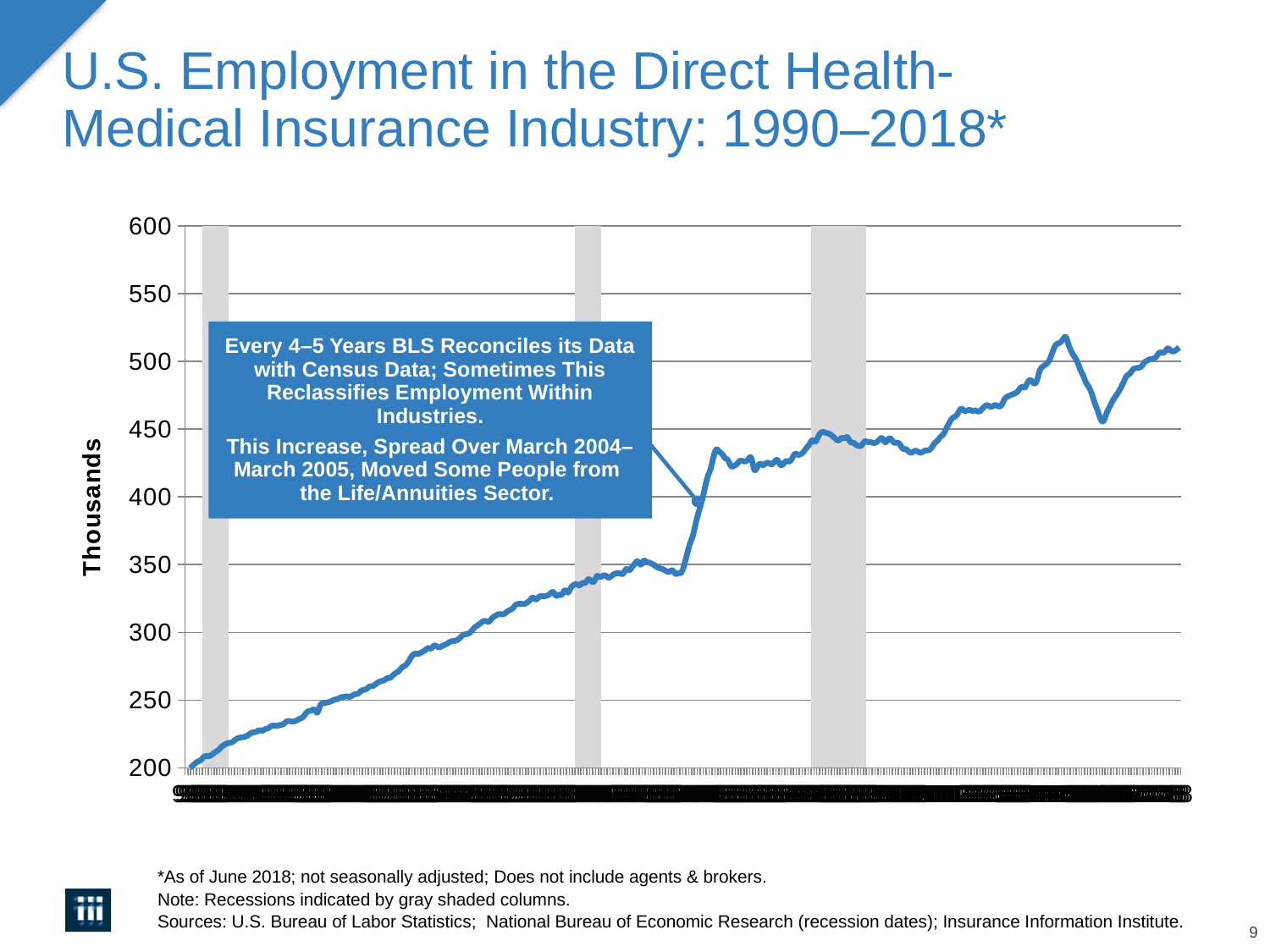
Is the value at the end of the series (June 2018) greater or less than 500? greater How many gray shaded recession columns appear on the chart? 3 Is the value at the start of the series (1990) greater or less than 250? less What is the highest value shown on the vertical axis? 600 Overall, do the values rise or fall from left to right along the x axis? rise According to the annotation box, over which period was the increase that moved some people from the Life/Annuities sector spread? March 2004–March 2005 What kind of chart is shown on the slide? line chart What is the label on the vertical axis of the chart? Thousands